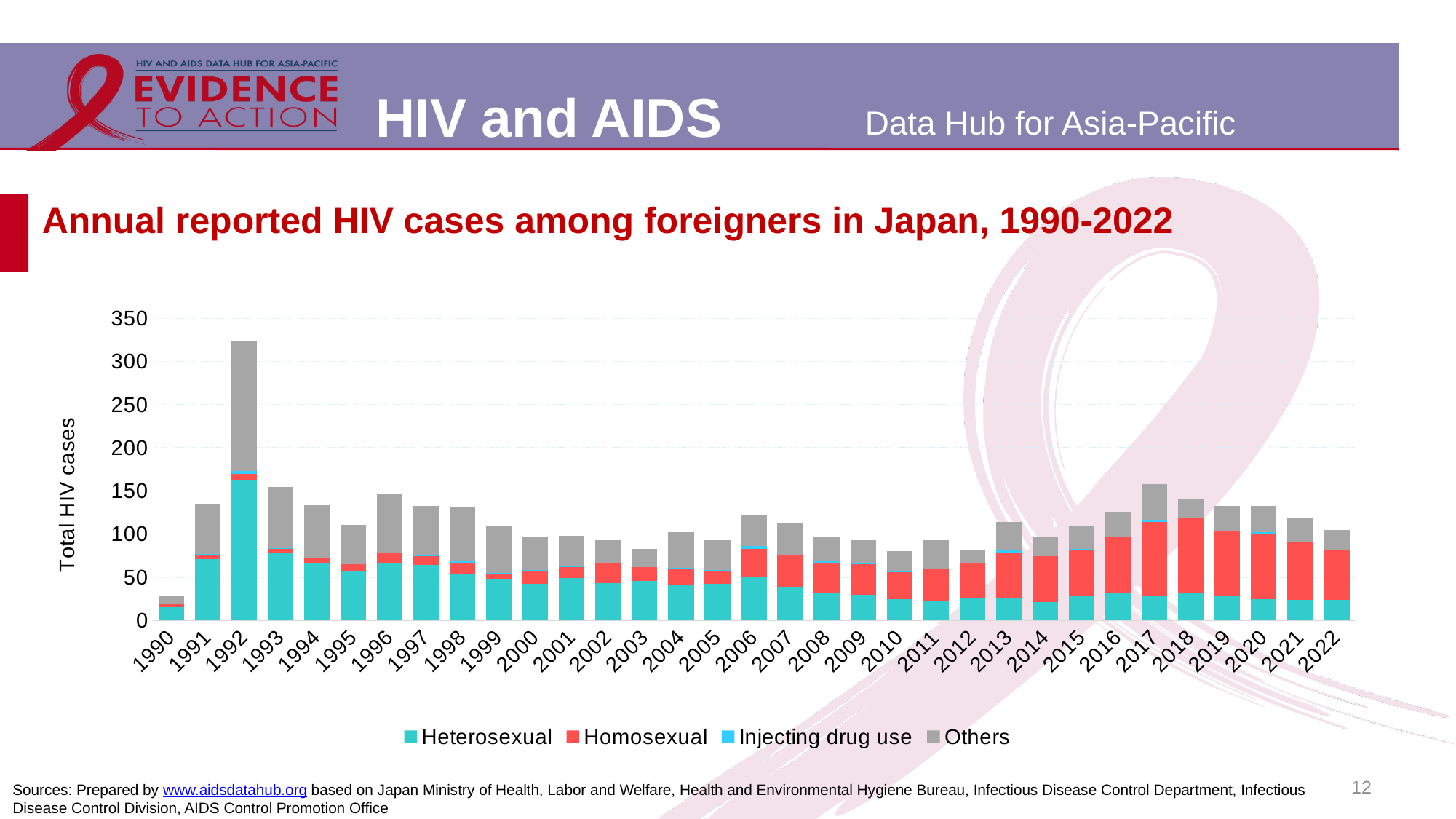
What kind of chart is shown on the slide? Stacked bar chart Which year has the lowest total of reported HIV cases among foreigners? 1990 How many years are shown along the x axis? 33 How many series does the legend list? 4 Do the total reported cases rise or fall from 2017 to 2022? fall Is the total value for 1990 greater or less than 50? less Is the total value for 2012 greater or less than 100? less Which year has the highest total of reported HIV cases among foreigners? 1992 What is the label on the y axis? Total HIV cases Is the total value for 1992 greater or less than 300? greater Which colour represents the 'Others' series in the legend? Grey Which year has a larger total of reported cases, 1991 or 2010? 1991